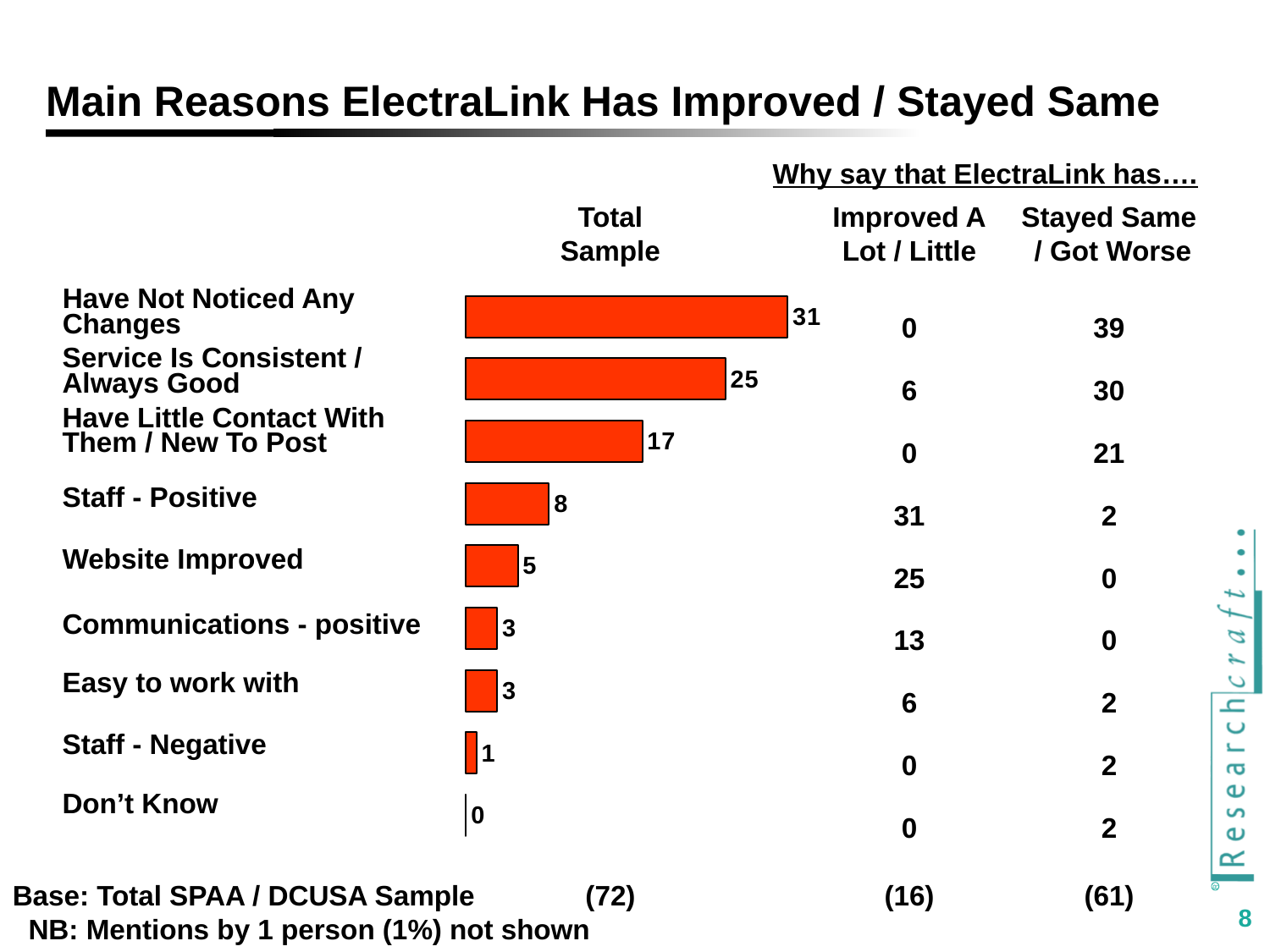
Which category has the highest Total Sample value in the bar chart? Have Not Noticed Any Changes Which category has the lowest Total Sample value in the bar chart? Don't Know How many categories are shown in the bar chart? 9 What is the difference between the Total Sample values for 'Have Not Noticed Any Changes' and 'Staff - Positive'? 23 What type of chart is used to show the Total Sample values? Bar chart What is the Total Sample value for 'Staff - Negative'? 1 Which has a larger Total Sample value: 'Staff - Positive' or 'Website Improved'? Staff - Positive What colour are the bars in the chart? Red-orange What is the Total Sample value for 'Have Not Noticed Any Changes'? 31 What is the Total Sample value for 'Website Improved'? 5 Do the Total Sample bar values rise or fall going down the chart from top to bottom? Fall What is the difference between the Total Sample values for 'Service Is Consistent / Always Good' and 'Have Little Contact With Them / New To Post'? 8